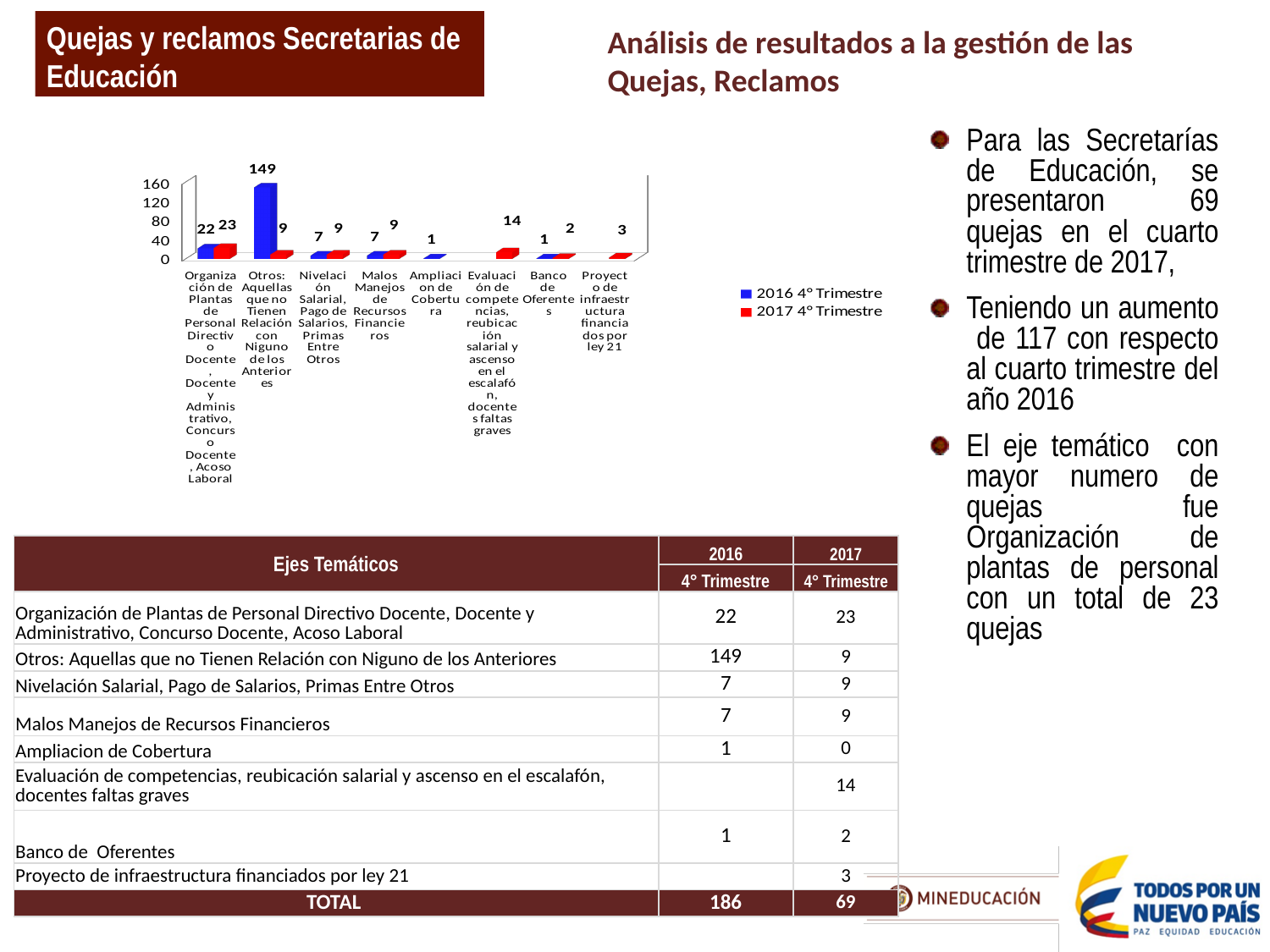
What is the value of the 2016 4° Trimestre bar for the category "Otros: Aquellas que no Tienen Relación con Niguno de los Anteriores"? 149 How many categories are shown on the x axis of the chart? 8 Which category has the highest 2016 4° Trimestre bar? Otros: Aquellas que no Tienen Relación con Niguno de los Anteriores How many series does the chart legend list? 2 What is the value of the 2017 4° Trimestre bar for "Evaluación de competencias, reubicación salarial y ascenso en el escalafón, docentes faltas graves"? 14 What kind of chart is shown on the slide? bar chart What is the difference between the 2016 and 2017 4° Trimestre values for the "Otros" category? 140 Which category has the highest 2017 4° Trimestre bar? Organización de Plantas de Personal Directivo Docente, Docente y Administrativo, Concurso Docente, Acoso Laboral What is the value of the 2017 4° Trimestre bar for "Banco de Oferentes"? 2 What are the two entries in the chart legend? 2016 4° Trimestre and 2017 4° Trimestre Is the 2016 4° Trimestre value for the "Otros" category greater or less than 120? greater For "Nivelación Salarial, Pago de Salarios, Primas Entre Otros", which series has the larger value, 2016 4° Trimestre or 2017 4° Trimestre? 2017 4° Trimestre